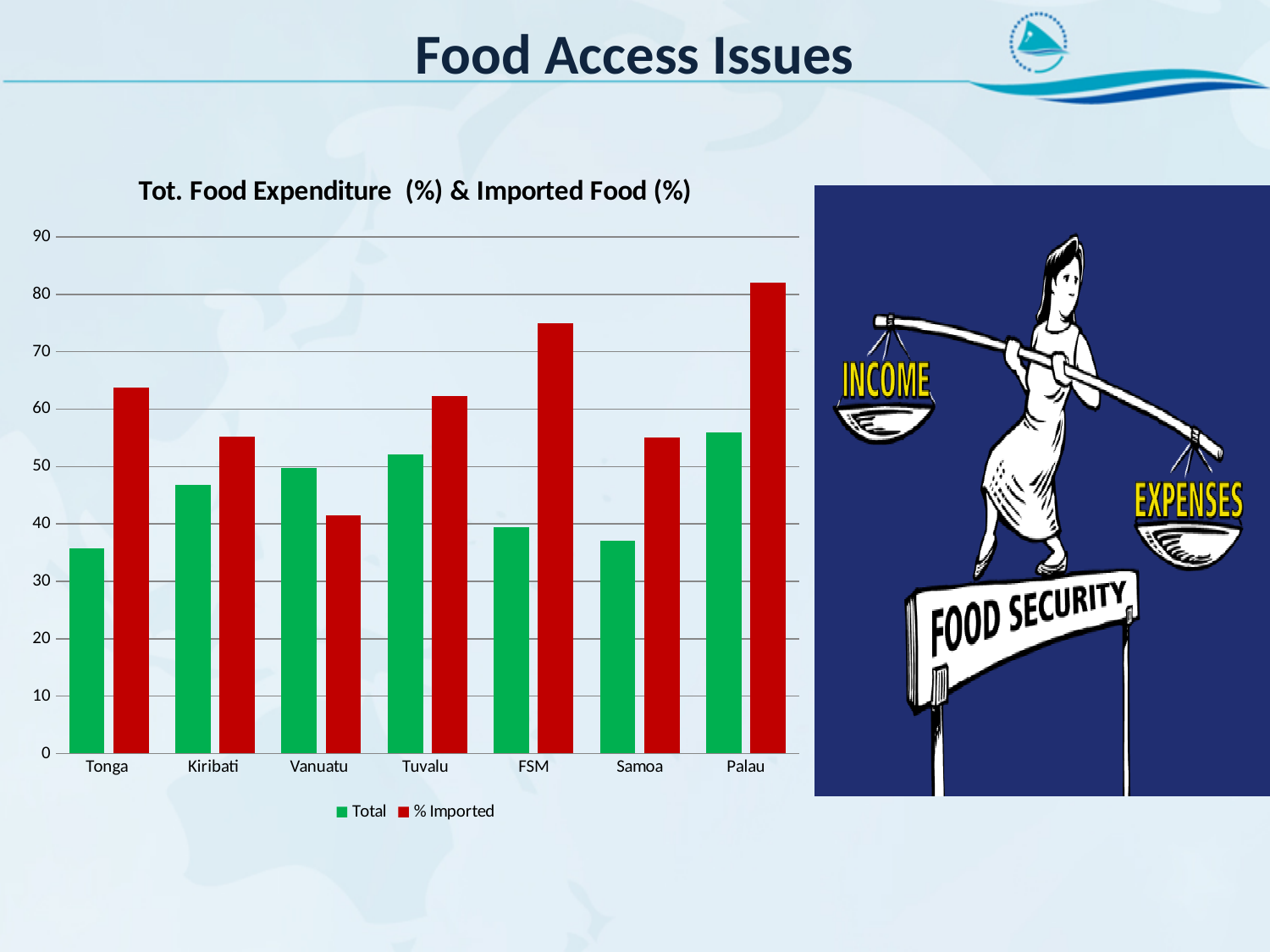
Which country has the lowest % Imported value? Vanuatu Is the % Imported value for Palau greater or less than 80? greater Which country has the highest % Imported value? Palau How many countries are shown on the x axis? 7 Is the Total value for Tonga greater or less than 40? less What is the title of the chart? Tot. Food Expenditure (%) & Imported Food (%) Is the % Imported value for FSM greater or less than 70? greater For Vanuatu, which is larger: the Total value or the % Imported value? Total Which country has the highest Total value? Palau Which series is shown in red? % Imported What kind of chart is shown on the slide? bar chart How many series does the legend list? 2